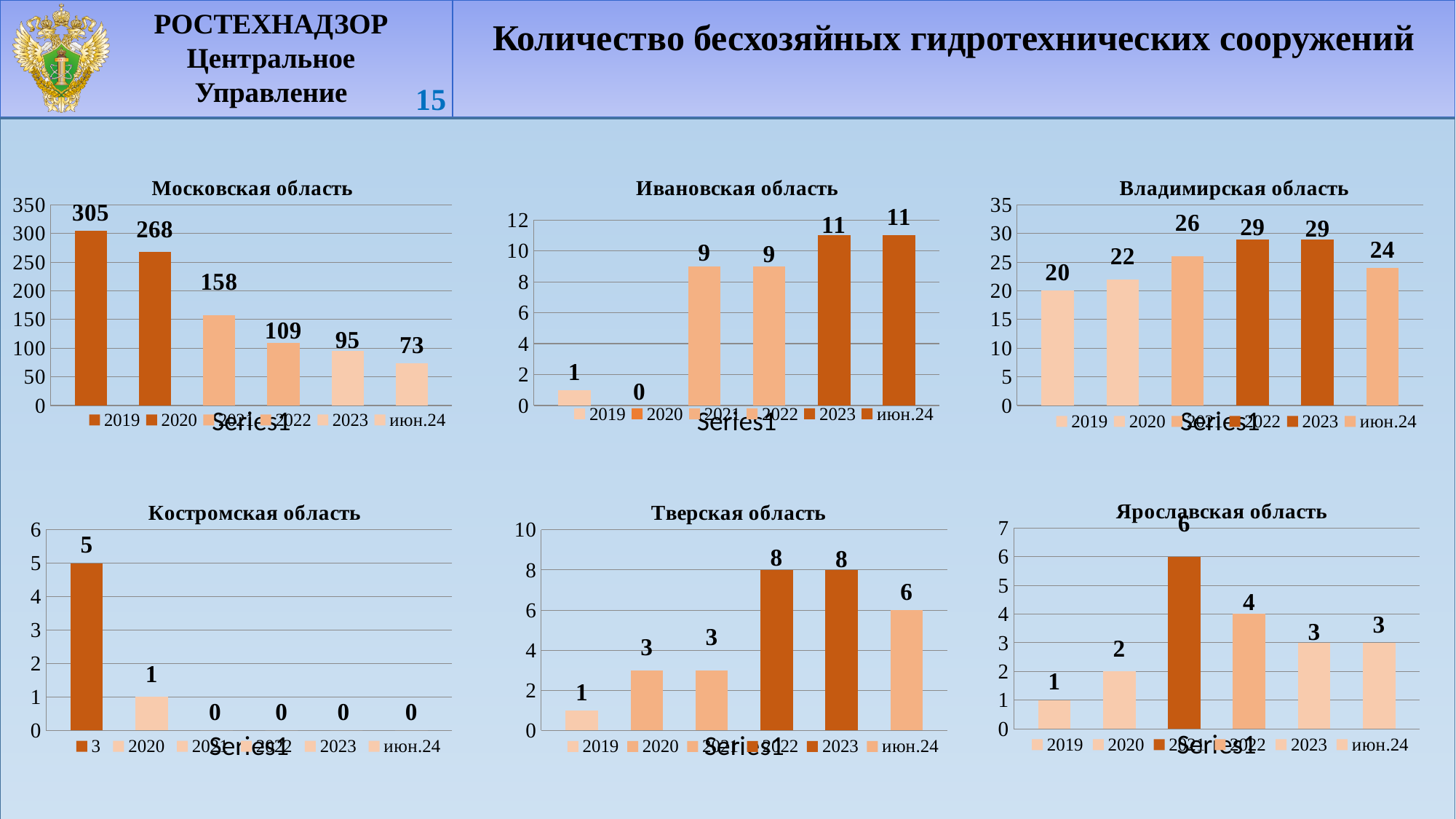
What kind of chart is the Тверская область chart? bar chart In the Костромская область chart, what is the value for 2020? 1 In the Владимирская область chart, what is the value for июн.24? 24 In the Тверская область chart, what is the value for июн.24? 6 How many bar charts are shown on the slide? 6 In the Ивановская область chart, what is the value for 2020? 0 In the Ярославская область chart, what is the difference between the 2023 value and the 2019 value? 2 In the Владимирская область chart, which is larger, the value for 2019 or the value for 2023? 2023 In the Ивановская область chart, which year has the lowest value? 2020 In the Московская область chart, what is the value for 2019? 305 In the Московская область chart, what is the difference between the 2019 and 2020 values? 37 In the Московская область chart, do the values rise or fall from 2019 to июн.24? fall